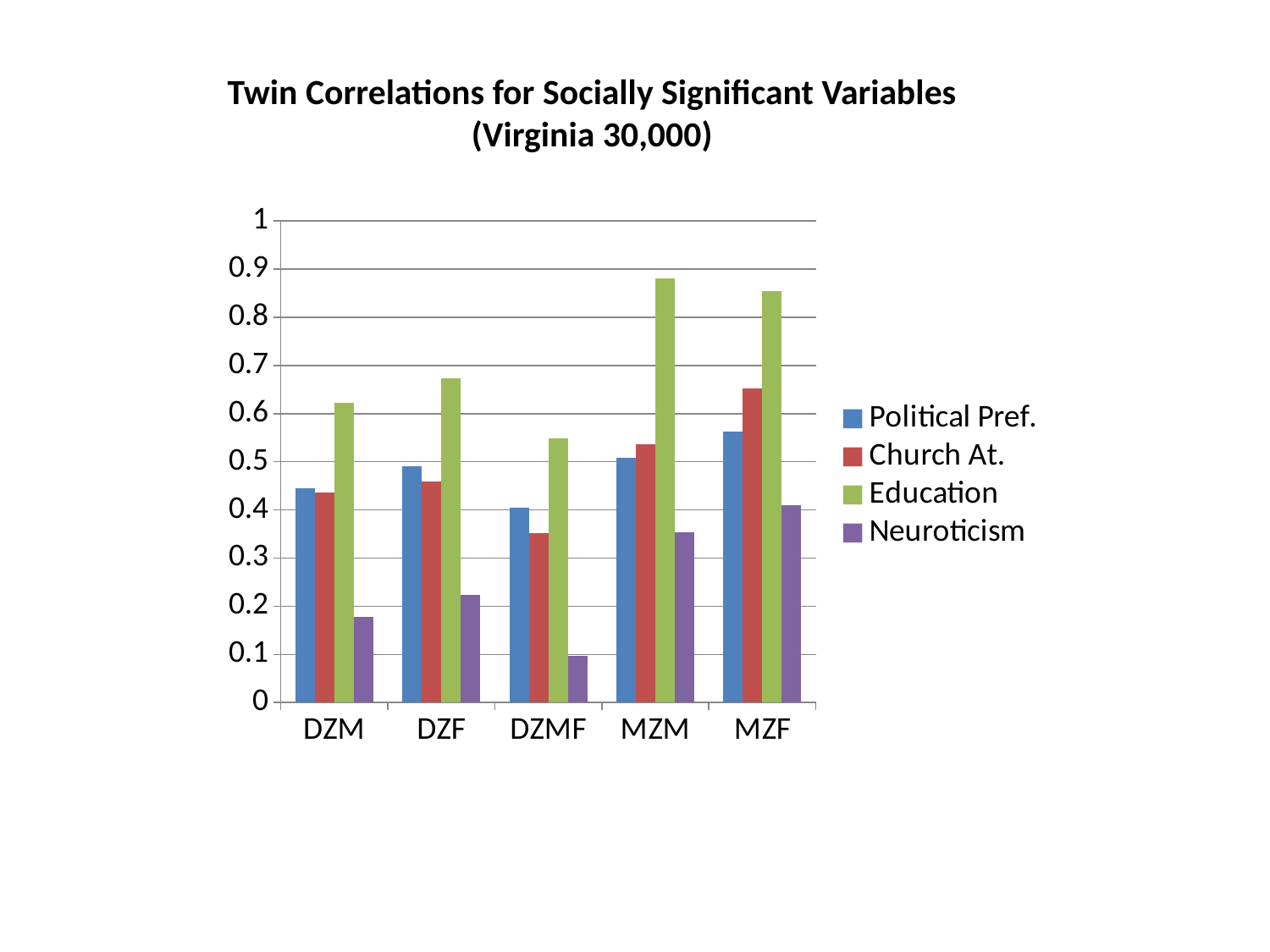
Which twin group has the lowest Neuroticism correlation? DZMF What is the title of the chart? Twin Correlations for Socially Significant Variables (Virginia 30,000) What kind of chart is shown on the slide? bar chart How many series does the legend list? 4 Is the Neuroticism value for DZMF greater or less than 0.2? less Which twin group has the highest Church At. correlation? MZF Which twin group has the lowest Education correlation? DZMF Which twin group has the highest Neuroticism correlation? MZF For MZF, which is larger: Church At. or Political Pref.? Church At. Which is larger: the Education value for DZF or for DZM? DZF How many twin groups (categories) are shown on the x axis? 5 Is the Education value for MZM greater or less than 0.8? greater